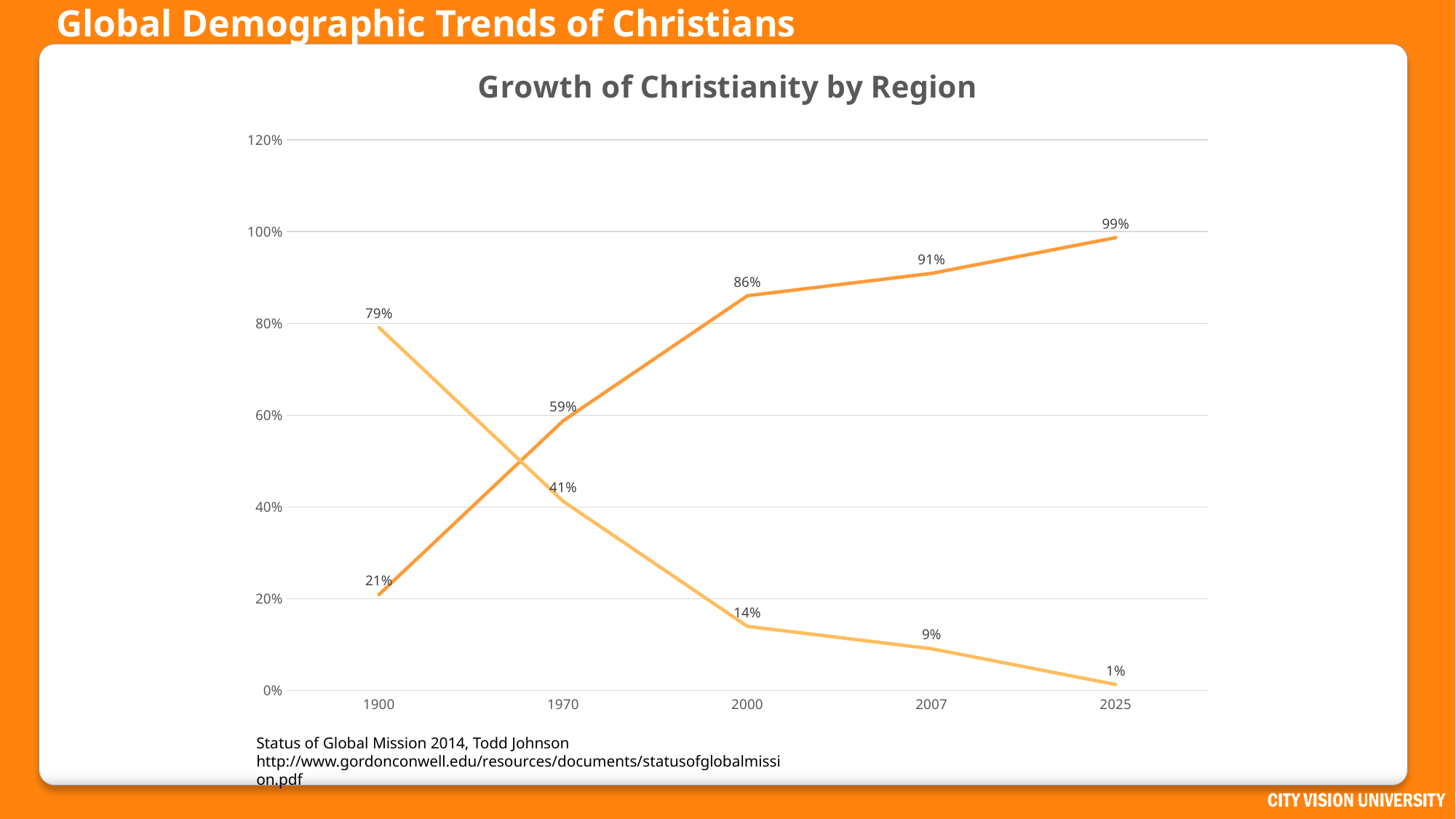
What type of chart is shown on the slide? line chart What is the value in 2000 for the line that starts at 79% in 1900? 14% What is the value in 2007 for the line that starts at 21% in 1900? 91% Does the line that starts at 79% in 1900 rise or fall from 1900 to 2025? fall In which year does the line that starts at 21% in 1900 reach its highest value? 2025 What is the difference between the two lines' values in 2000? 72% What is the value in 2025 for the line that starts at 21% in 1900? 99% Which line has the larger value in 1970: the one that starts at 21% in 1900 or the one that starts at 79% in 1900? the one that starts at 21% in 1900 What is the title of the chart? Growth of Christianity by Region How many years are shown on the x axis of the chart? 5 In which year does the line that starts at 79% in 1900 reach its lowest value? 2025 What is the value in 1970 for the line that starts at 79% in 1900? 41%